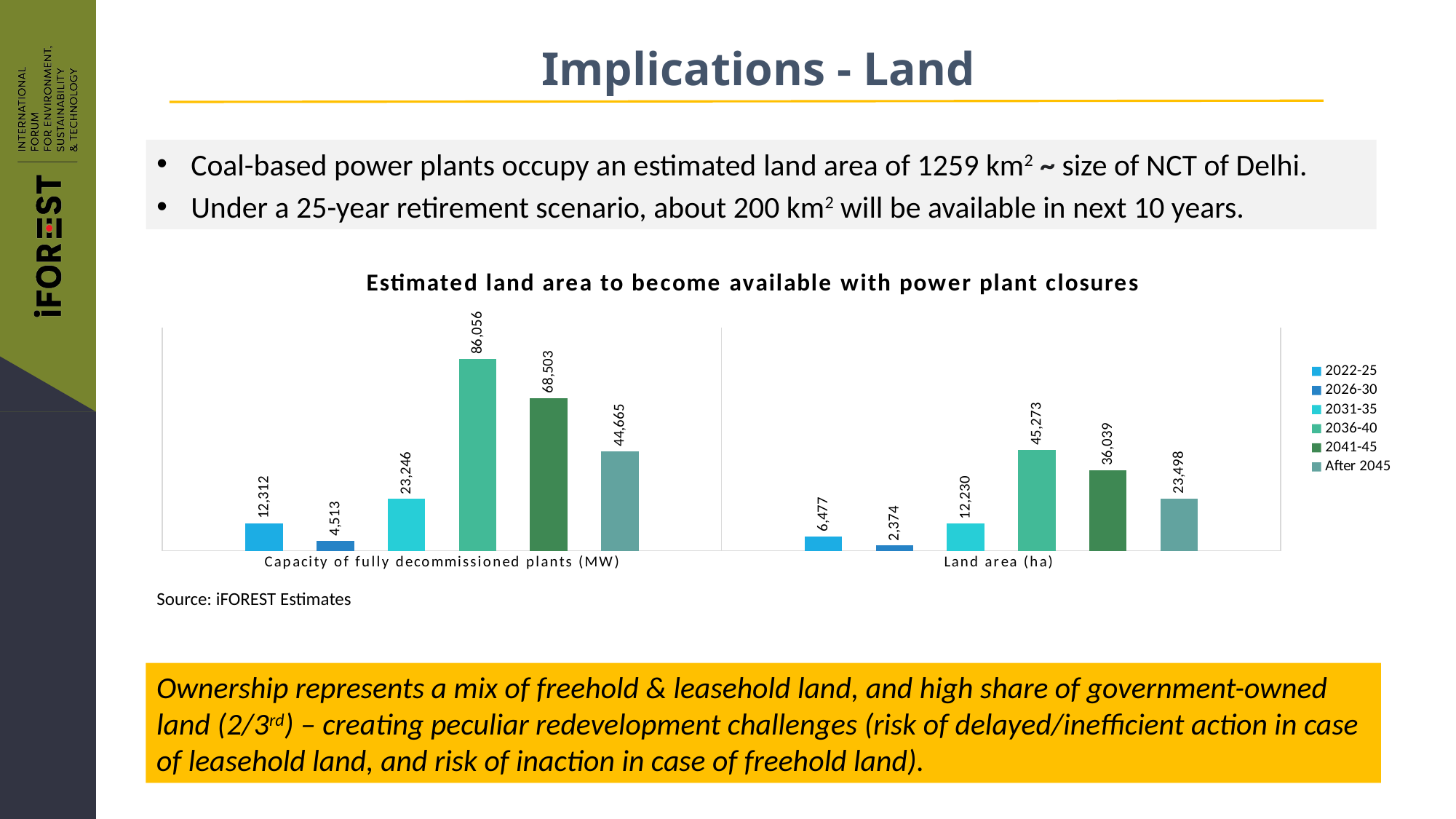
How many series does the legend list? 6 What is the title of the chart? Estimated land area to become available with power plant closures How many categories are shown on the x axis? 2 Which is larger: the land area (ha) for 2022-25 or for 2031-35? 2031-35 What is the land area (ha) for 2041-45? 36,039 What is the capacity of fully decommissioned plants (MW) for 2036-40? 86,056 What is the land area (ha) for 2026-30? 2,374 What kind of chart is shown on the slide? Bar chart What is the difference between the land area (ha) for 2036-40 and After 2045? 21,775 What is the difference between the capacity of fully decommissioned plants (MW) for 2036-40 and 2041-45? 17,553 Which period has the lowest capacity of fully decommissioned plants (MW)? 2026-30 Which period has the highest land area (ha)? 2036-40